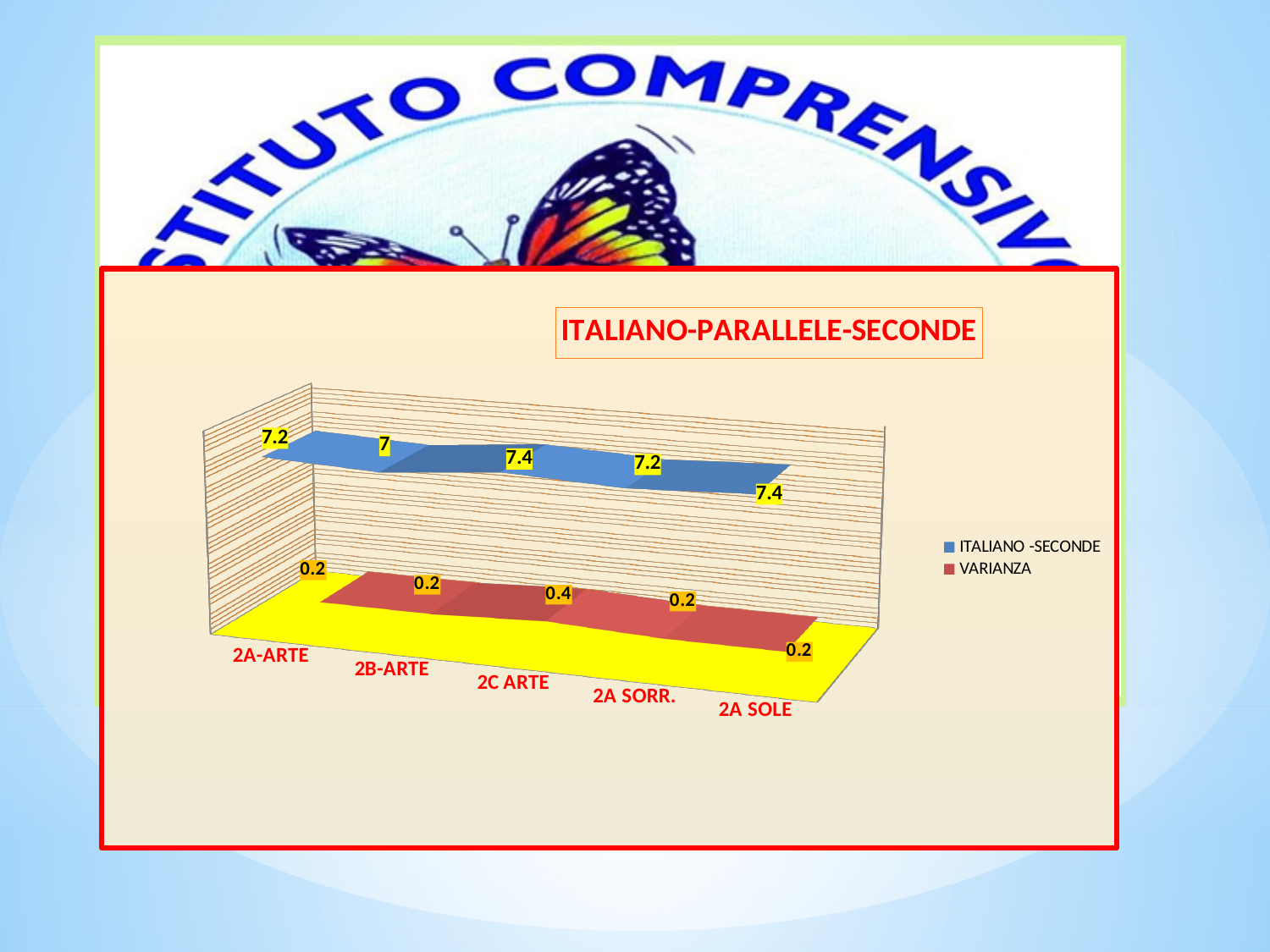
What is the VARIANZA value for 2A SOLE? 0.2 What is the ITALIANO -SECONDE value for 2C ARTE? 7.4 What is the VARIANZA value for 2C ARTE? 0.4 What kind of chart is shown? 3D line chart Which is larger, the ITALIANO -SECONDE value for 2A-ARTE or for 2A SOLE? 2A SOLE What is the difference between the ITALIANO -SECONDE values for 2C ARTE and 2B-ARTE? 0.4 Which category has the lowest ITALIANO -SECONDE value? 2B-ARTE Which category has the highest VARIANZA value? 2C ARTE How many series does the legend list? 2 What is the title of the chart? ITALIANO-PARALLELE-SECONDE How many categories are shown on the x axis? 5 What is the ITALIANO -SECONDE value for 2B-ARTE? 7